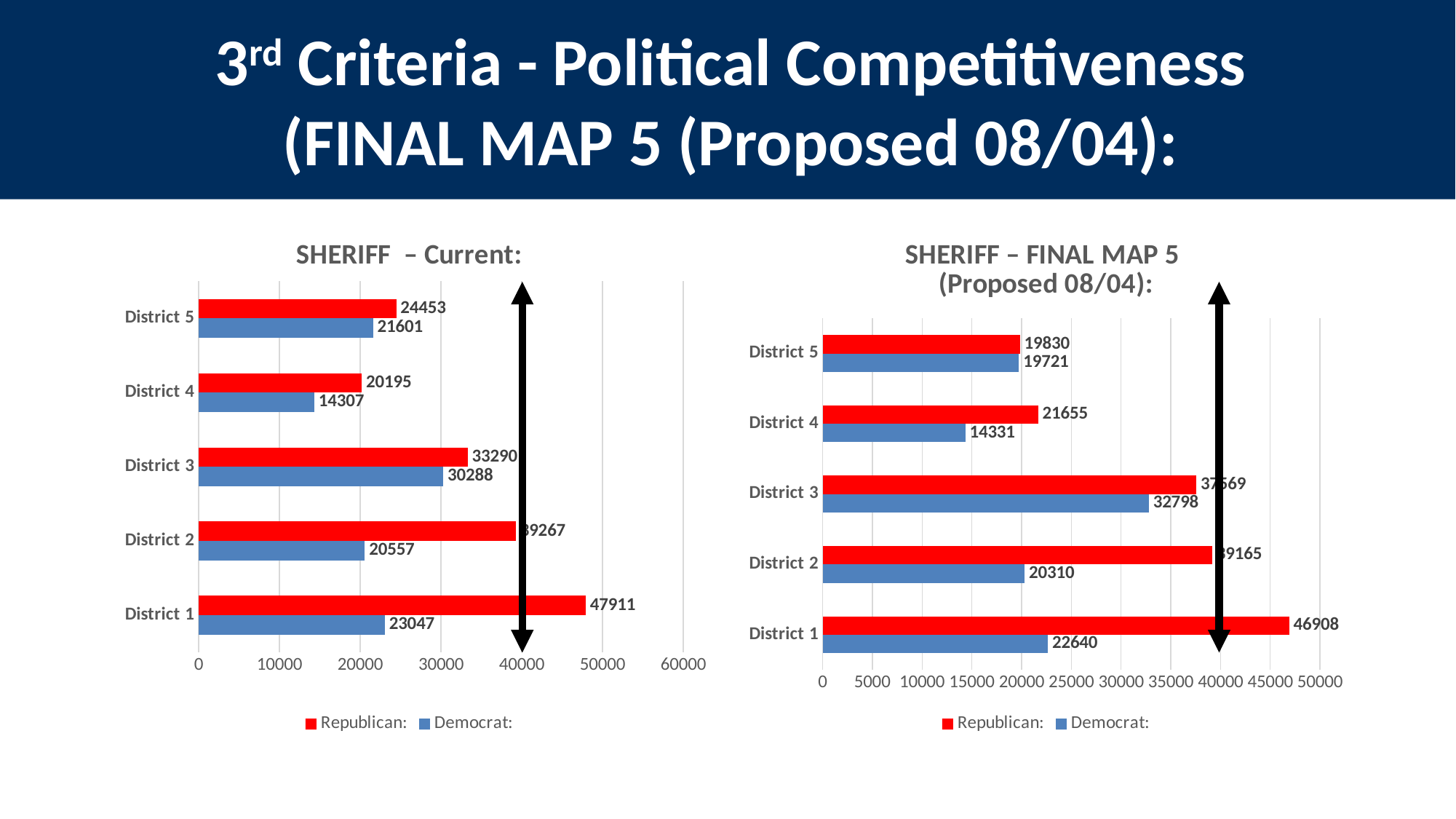
How many districts are shown in the SHERIFF – Current chart? 5 In the SHERIFF – Current chart, what is the difference between the Republican and Democrat values for District 1? 24864 How many series does the legend of the SHERIFF – FINAL MAP 5 chart list? 2 In the SHERIFF – FINAL MAP 5 chart, what is the difference between the Republican and Democrat values for District 4? 7324 In the SHERIFF – FINAL MAP 5 chart, which district has the lowest Democrat value? District 4 In the SHERIFF – Current chart, what is the Republican value for District 1? 47911 In the SHERIFF – FINAL MAP 5 chart, is the Republican value for District 1 greater or less than 45000? greater In the SHERIFF – FINAL MAP 5 chart, what is the Republican value for District 5? 19830 In the SHERIFF – Current chart, which district has the highest Republican value? District 1 In the SHERIFF – FINAL MAP 5 chart, what is the Democrat value for District 3? 32798 In the SHERIFF – Current chart, is the Democrat value for District 3 larger than the Democrat value for District 5? Yes In the SHERIFF – Current chart, what is the Democrat value for District 4? 14307